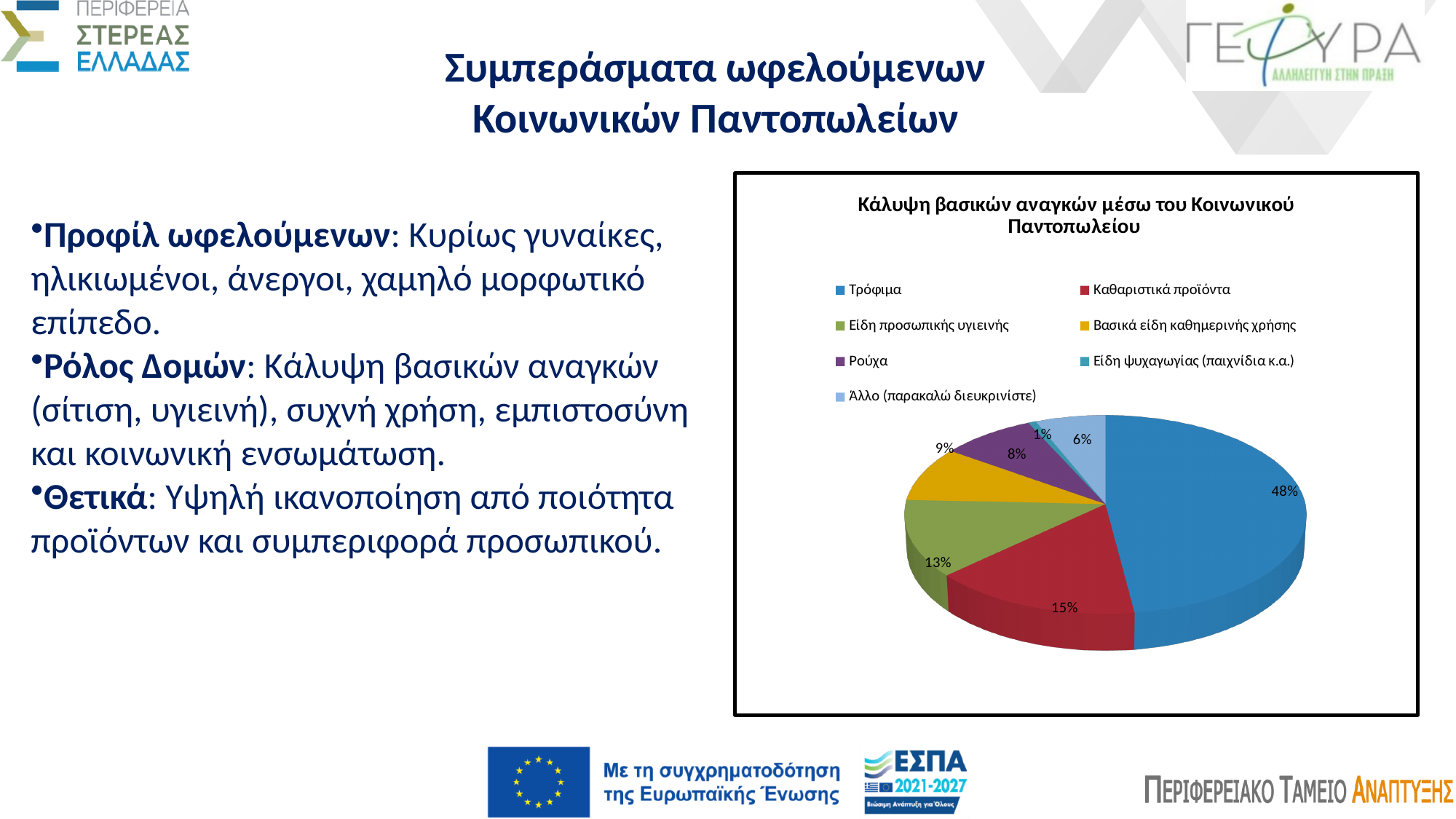
What share of the pie does Είδη προσωπικής υγιεινής have? 13% What share of the pie does Άλλο (παρακαλώ διευκρινίστε) have? 6% What share of the pie does Καθαριστικά προϊόντα have? 15% What kind of chart is shown on the slide? pie chart What is the difference in percentage points between Τρόφιμα and Καθαριστικά προϊόντα? 33 Which category has the largest slice of the pie? Τρόφιμα What is the title of the pie chart? Κάλυψη βασικών αναγκών μέσω του Κοινωνικού Παντοπωλείου Which category has the smallest slice of the pie? Είδη ψυχαγωγίας (παιχνίδια κ.α.) Which is larger, the share for Βασικά είδη καθημερινής χρήσης or the share for Ρούχα? Βασικά είδη καθημερινής χρήσης How many categories does the pie chart's legend list? 7